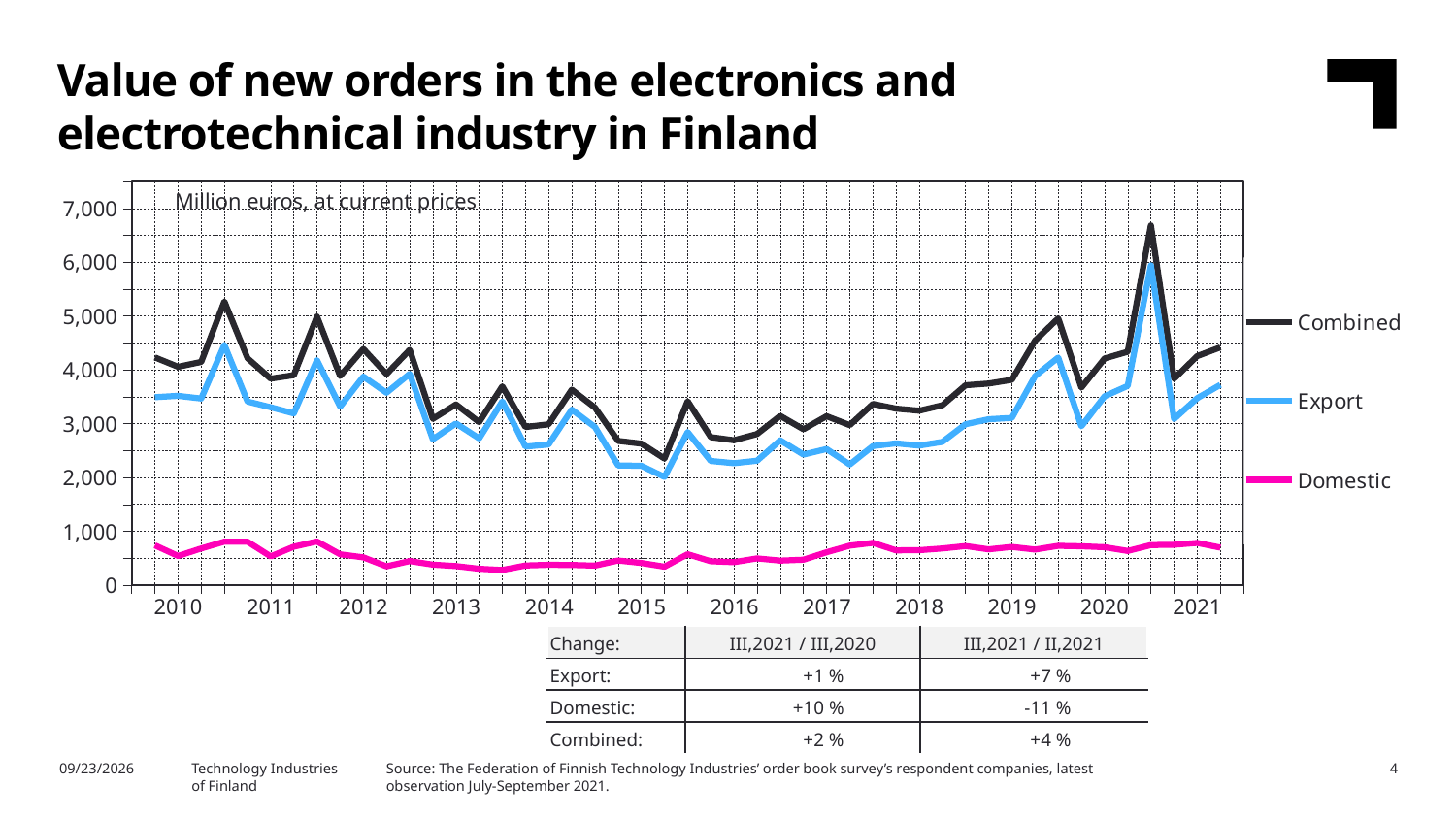
Is the value for Domestic in 2015 greater or less than 1,000? less What are the three series named in the legend? Combined, Export, Domestic Is the peak value of the Combined series in 2020 greater or less than 6,000? greater What unit label is printed inside the chart area? Million euros, at current prices Is the value for Export at the start of 2016 greater or less than 3,000? less In 2021, which is larger, the Export value or the Domestic value? Export What kind of chart is shown on the slide? Line chart How many years are labeled on the x axis? 12 Does the Combined series rise or fall overall from 2010 to 2015? Fall How many series does the legend list? 3 Which series has the lowest values across the whole chart? Domestic Which series has the highest values across the whole chart? Combined